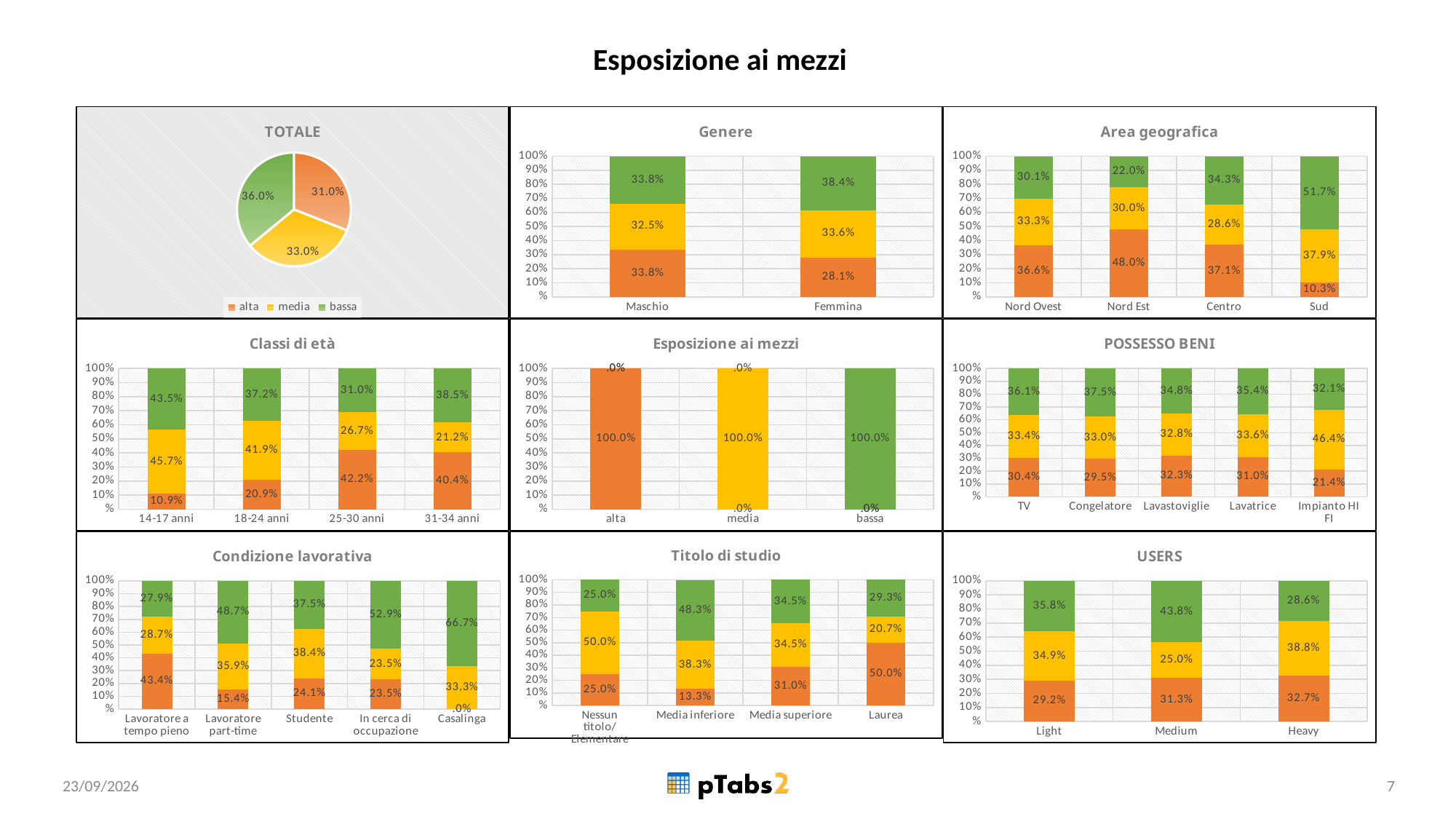
In the Area geografica chart, which region has the highest orange (alta) value? Nord Est In the Genere chart, what is the value of the green (bassa) segment for Femmina? 38.4% In the Titolo di studio chart, what is the orange (alta) value for Laurea? 50.0% In the USERS chart, what is the green (bassa) value for Medium? 43.8% What kind of chart is the TOTALE chart? pie chart In the POSSESSO BENI chart, what is the yellow (media) value for Impianto HI FI? 46.4% In the Area geografica chart, what is the difference between the green (bassa) values for Sud and Nord Est? 29.7% In the TOTALE pie chart, what share is labelled for the bassa slice? 36.0% How many series does the legend of the TOTALE chart list? 3 In the Classi di età chart, which age class has the lowest orange (alta) value? 14-17 anni In the Condizione lavorativa chart, which is larger: the green (bassa) value for Casalinga or for In cerca di occupazione? Casalinga How many categories are shown on the x axis of the POSSESSO BENI chart? 5